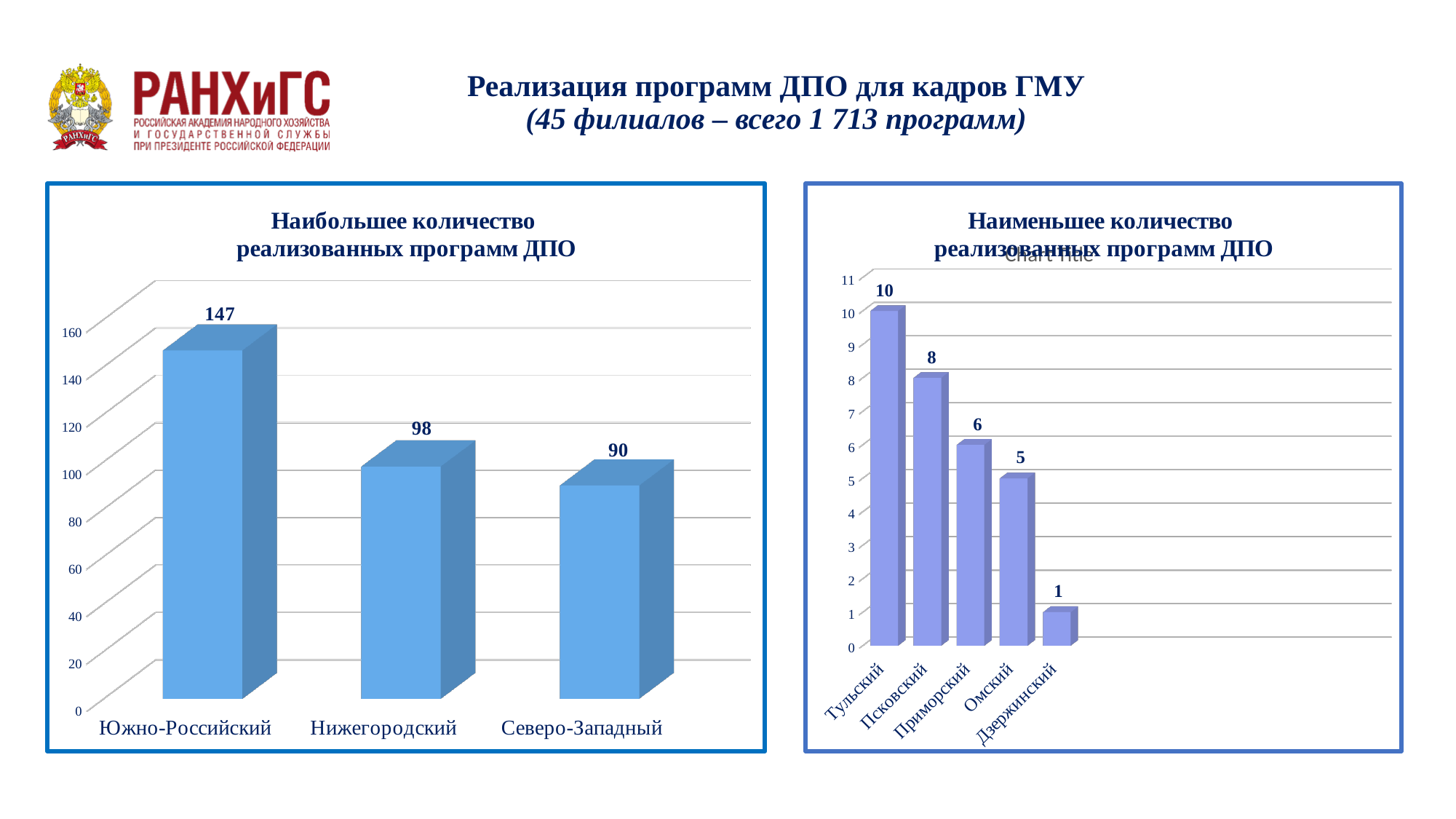
In the right chart (Наименьшее количество реализованных программ ДПО), which is larger, Приморский or Омский? Приморский In the left chart (Наибольшее количество реализованных программ ДПО), what is the value for Северо-Западный? 90 In the right chart (Наименьшее количество реализованных программ ДПО), how many categories are shown? 5 In the left chart (Наибольшее количество реализованных программ ДПО), what is the value for Южно-Российский? 147 In the left chart (Наибольшее количество реализованных программ ДПО), what is the difference between Южно-Российский and Нижегородский? 49 In the right chart (Наименьшее количество реализованных программ ДПО), what is the value for Дзержинский? 1 In the right chart (Наименьшее количество реализованных программ ДПО), do the values rise or fall from left to right? fall In the left chart (Наибольшее количество реализованных программ ДПО), how many categories are shown? 3 In the left chart (Наибольшее количество реализованных программ ДПО), which category has the lowest value? Северо-Западный In the right chart (Наименьшее количество реализованных программ ДПО), what is the value for Псковский? 8 What kind of chart is the left chart (Наибольшее количество реализованных программ ДПО)? bar chart In the right chart (Наименьшее количество реализованных программ ДПО), which category has the highest value? Тульский